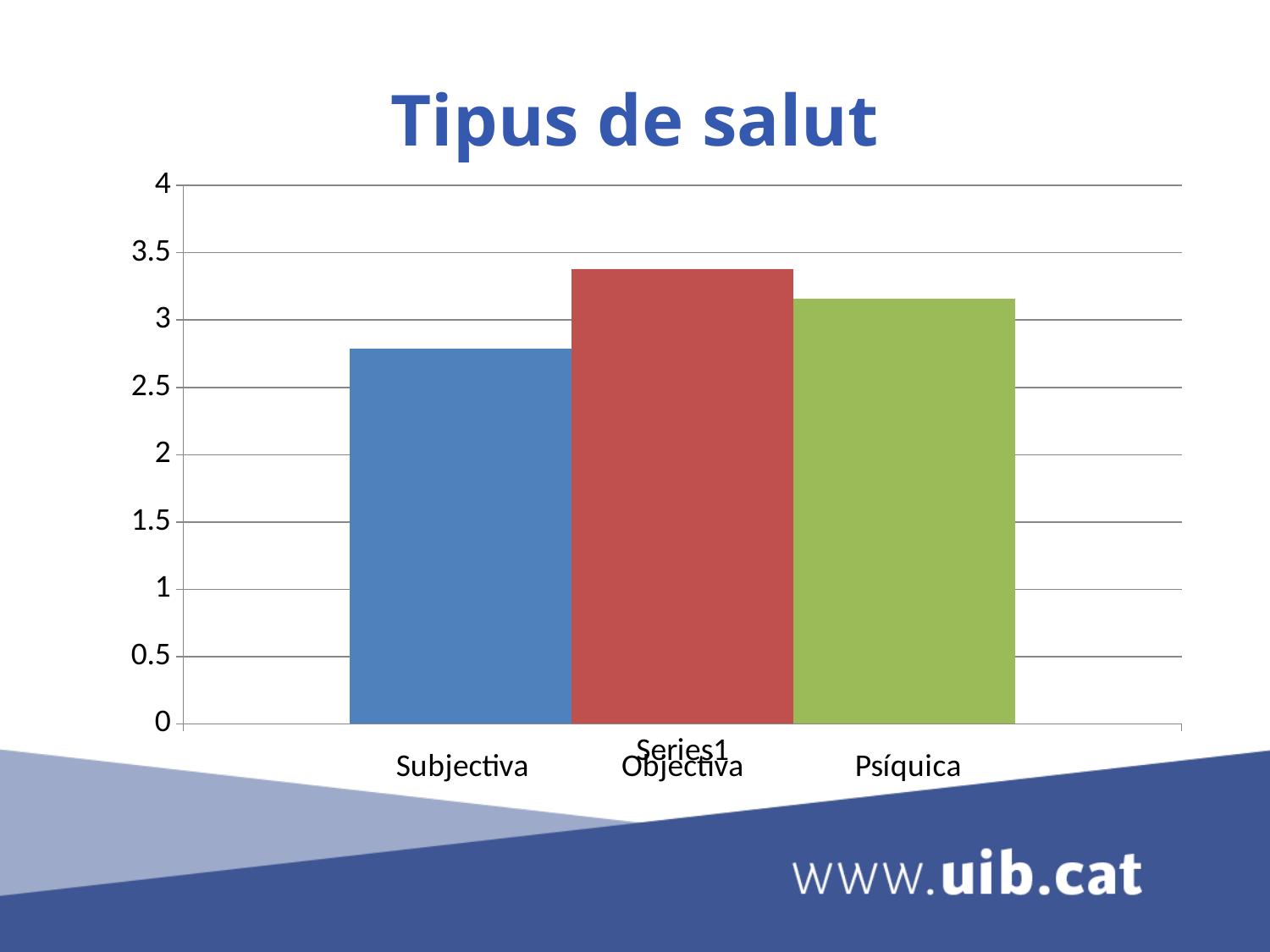
Which is larger, the value for Subjectiva or the value for Psíquica? Psíquica Which category has the highest value? Objectiva Which is larger, the value for Objectiva or the value for Psíquica? Objectiva How many categories are shown on the x axis? 3 Is the value for Subjectiva greater or less than 2.5? greater Is the value for Subjectiva greater or less than 3? less Which category has the lowest value? Subjectiva What is the highest value shown on the vertical axis? 4 What kind of chart is shown on the slide? bar chart Is the value for Objectiva greater or less than 3? greater What is the title of the chart? Tipus de salut